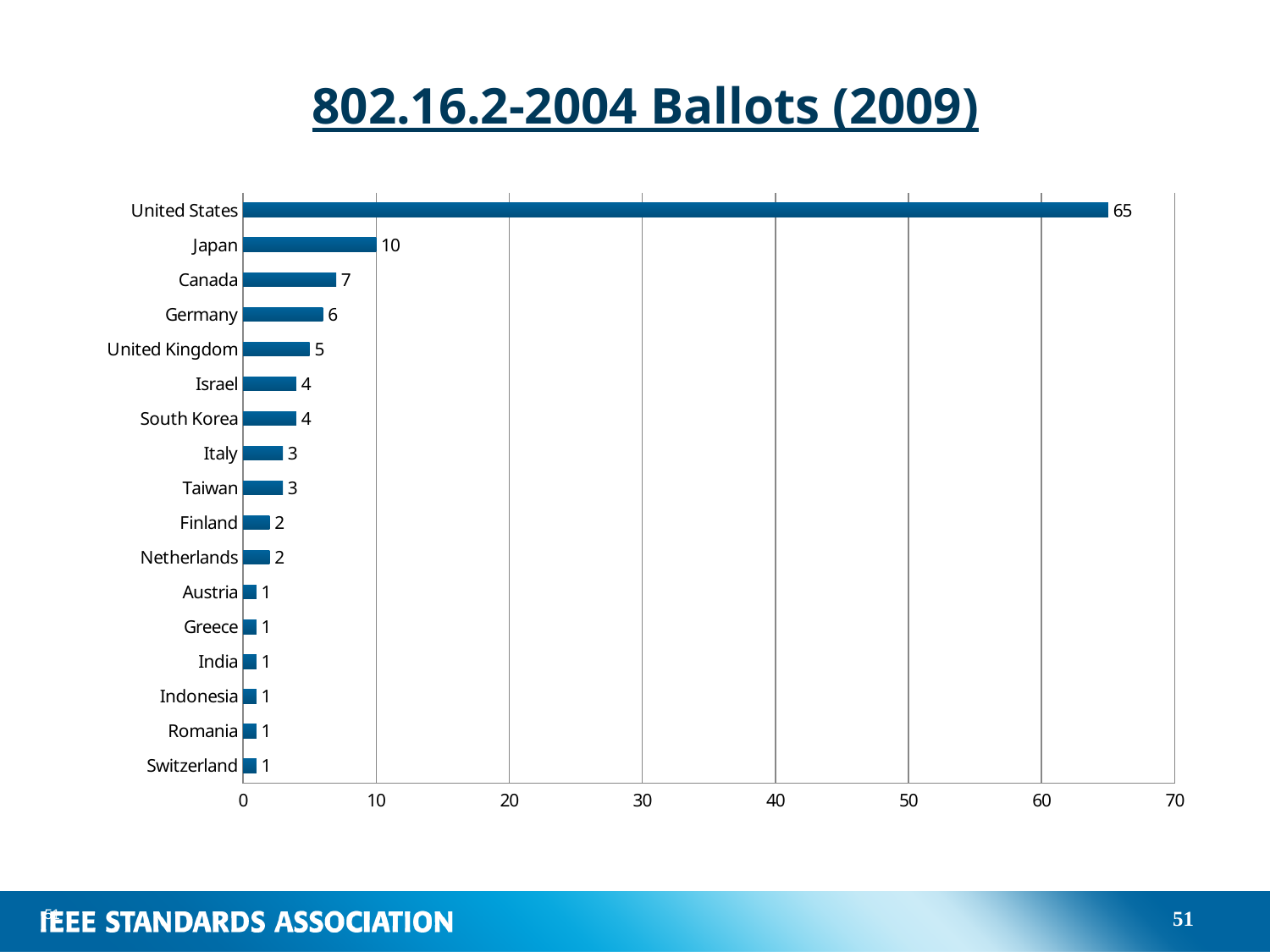
What is the value for United States? 65 What is the value for Japan? 10 How many countries are shown in the chart? 17 Is the value for United States greater or less than 60? greater What is the maximum value shown on the x axis? 70 What is the difference between the values for United States and Japan? 55 Which country has the highest value? United States Which has a larger value, Japan or Canada? Japan What is the title of the chart? 802.16.2-2004 Ballots (2009) What is the value for United Kingdom? 5 What is the difference between the values for Canada and Germany? 1 What kind of chart is shown on the slide? bar chart